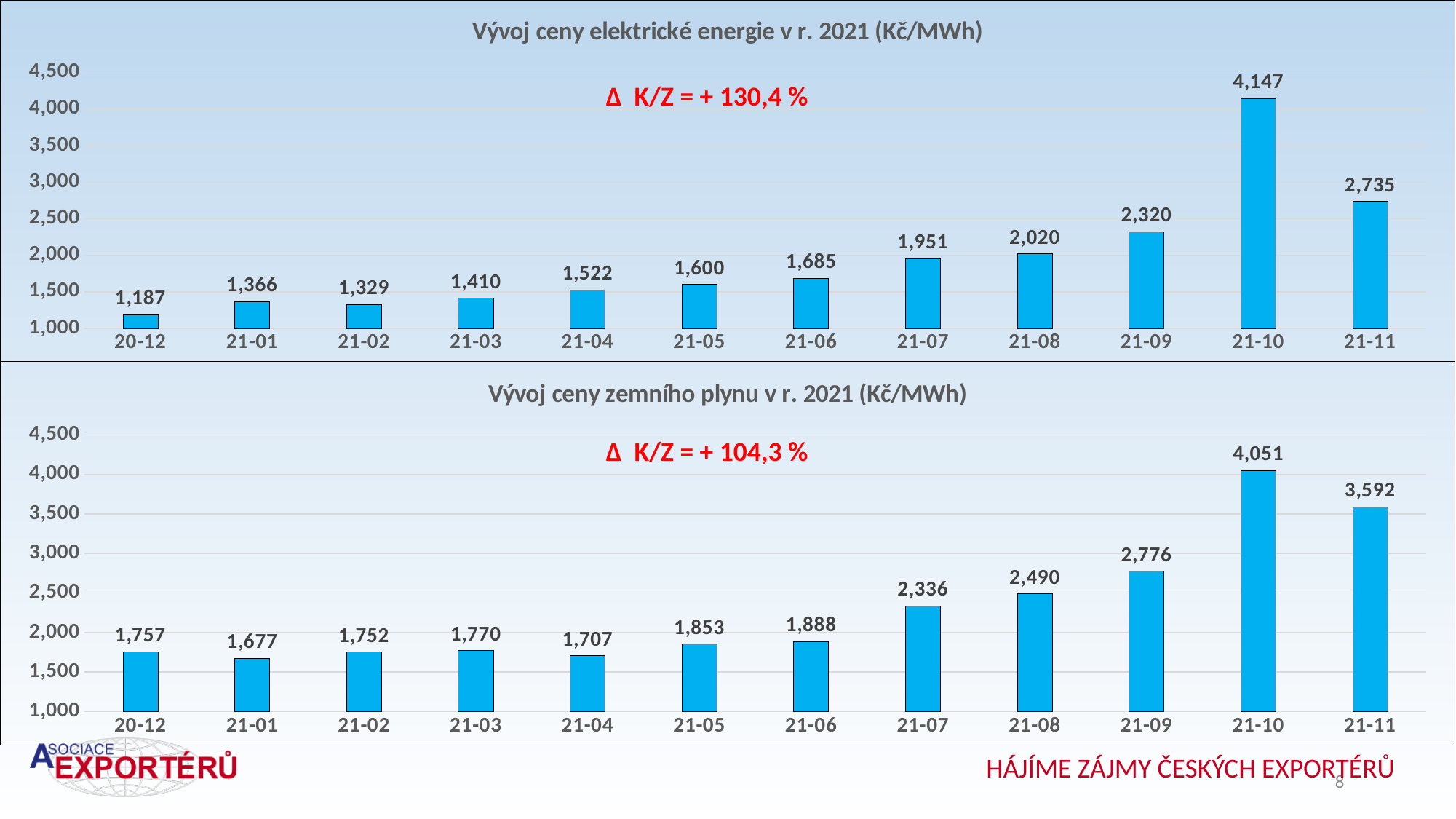
In the bottom chart 'Vývoj ceny zemního plynu v r. 2021 (Kč/MWh)', what is the difference between the values for 21-09 and 21-08? 286 How many months are shown on the x axis of the top chart 'Vývoj ceny elektrické energie v r. 2021 (Kč/MWh)'? 12 In the top chart 'Vývoj ceny elektrické energie v r. 2021 (Kč/MWh)', what is the value for 21-10? 4,147 What kind of chart is the bottom chart 'Vývoj ceny zemního plynu v r. 2021 (Kč/MWh)'? bar chart In the top chart 'Vývoj ceny elektrické energie v r. 2021 (Kč/MWh)', what percentage change is shown in the red annotation? + 130,4 % In the top chart 'Vývoj ceny elektrické energie v r. 2021 (Kč/MWh)', which is larger, the value for 21-01 or 21-02? 21-01 In the bottom chart 'Vývoj ceny zemního plynu v r. 2021 (Kč/MWh)', which month has the highest value? 21-10 In the top chart 'Vývoj ceny elektrické energie v r. 2021 (Kč/MWh)', which month has the lowest value? 20-12 In the top chart 'Vývoj ceny elektrické energie v r. 2021 (Kč/MWh)', what is the difference between the values for 21-10 and 21-11? 1,412 In the bottom chart 'Vývoj ceny zemního plynu v r. 2021 (Kč/MWh)', which month has the lowest value? 21-01 In the bottom chart 'Vývoj ceny zemního plynu v r. 2021 (Kč/MWh)', is the value for 21-07 greater or less than 2,000? greater In the bottom chart 'Vývoj ceny zemního plynu v r. 2021 (Kč/MWh)', what is the value for 21-11? 3,592